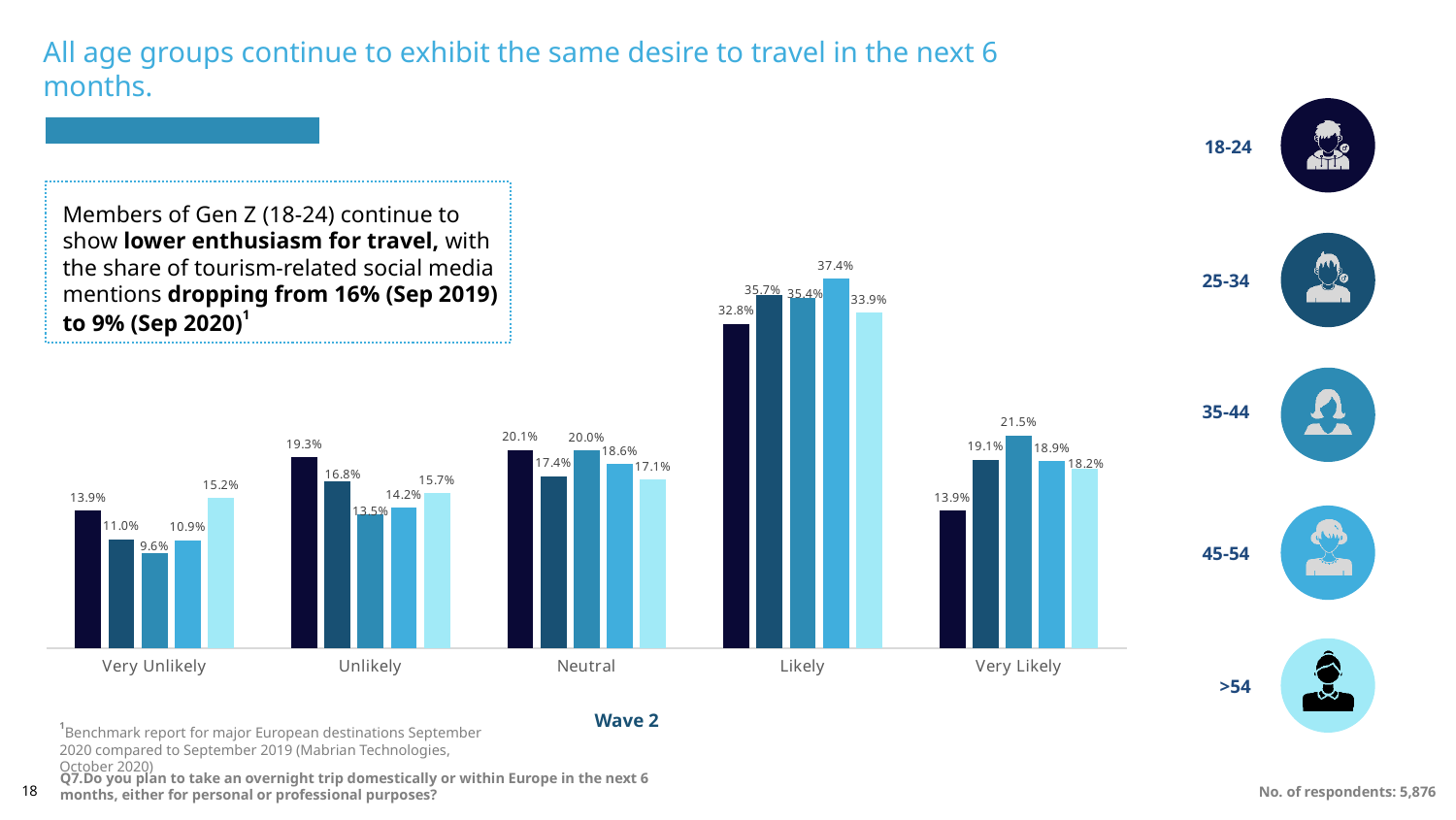
How many response categories are shown along the x axis of the chart? 5 What is the value for the 18-24 age group in the Very Likely category? 13.9% What wave label is shown beneath the chart? Wave 2 What kind of chart is shown on the slide? bar chart What is the difference between the 45-54 and 18-24 values in the Likely category? 4.6% Which response category has the highest values across all age groups? Likely Which age group has the lowest value in the Very Unlikely category? 35-44 How many age groups (series) are shown in the chart's legend on the right? 5 In the Unlikely category, which is larger: the value for 18-24 or the value for 35-44? 18-24 What is the value for the 45-54 age group in the Likely category? 37.4% What is the value for the >54 age group in the Very Unlikely category? 15.2% Which age group has the highest value in the Very Likely category? 35-44